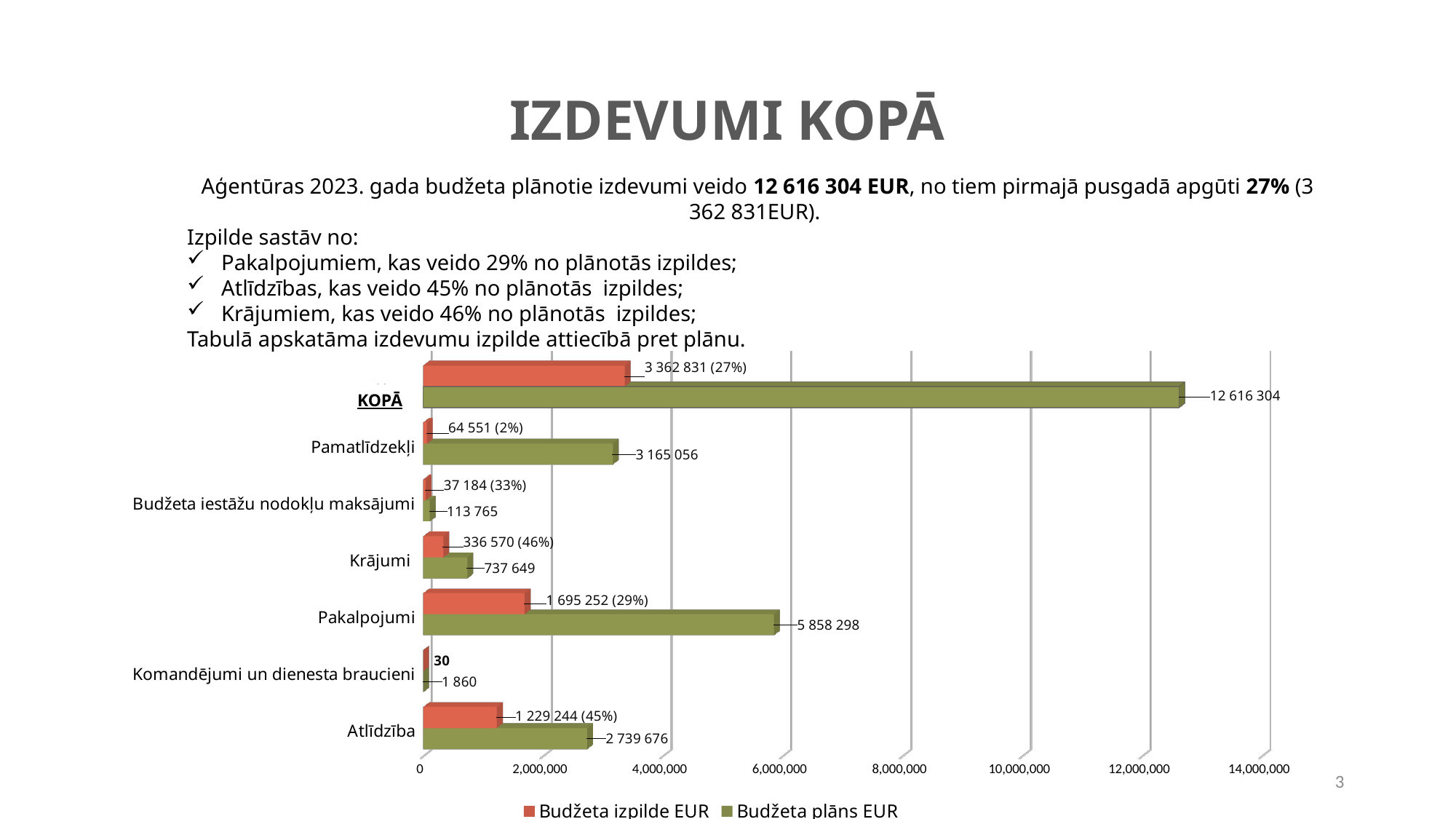
What is the Budžeta izpilde EUR value for Atlīdzība? 1 229 244 (45%) What kind of chart is shown on the slide? bar chart Excluding KOPĀ, which category has the highest Budžeta plāns EUR value? Pakalpojumi What is the Budžeta plāns EUR value for Komandējumi un dienesta braucieni? 1 860 What is the Budžeta plāns EUR value for KOPĀ? 12 616 304 Which series is shown in green on the chart? Budžeta plāns EUR Which category has the lowest Budžeta izpilde EUR value? Komandējumi un dienesta braucieni What is the Budžeta plāns EUR value for Pakalpojumi? 5 858 298 Which is larger: the Budžeta plāns EUR value for Pamatlīdzekļi or for Atlīdzība? Pamatlīdzekļi How many series does the chart legend list? 2 How many categories are shown on the chart's vertical axis? 7 What is the difference between the Budžeta plāns EUR and Budžeta izpilde EUR values for Krājumi? 401 079